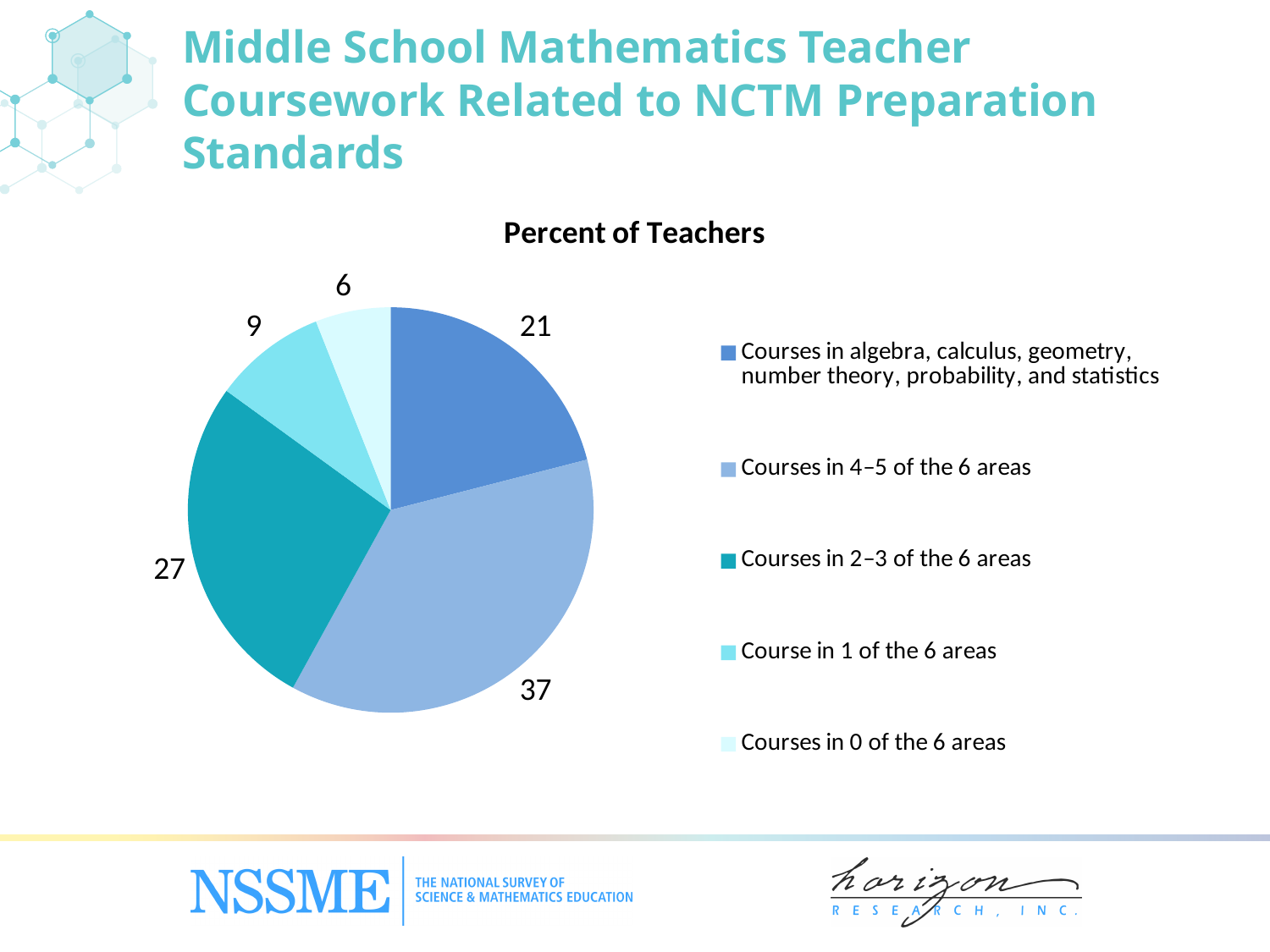
What percent of teachers had courses in 0 of the 6 areas? 6 Which category has the smallest slice of the pie? Courses in 0 of the 6 areas How many categories does the legend list? 5 Which is larger: the slice for courses in 2–3 of the 6 areas or the slice for courses in all six areas (algebra, calculus, geometry, number theory, probability, and statistics)? Courses in 2–3 of the 6 areas What type of chart is shown on the slide? pie chart What percent of teachers had a course in 1 of the 6 areas? 9 What is the chart's title? Percent of Teachers What percent of teachers had courses in algebra, calculus, geometry, number theory, probability, and statistics? 21 Which category has the largest slice of the pie? Courses in 4–5 of the 6 areas What is the combined percent of teachers with a course in 1 of the 6 areas and courses in 0 of the 6 areas? 15 What is the difference between the percent of teachers with courses in 4–5 of the 6 areas and those with courses in 2–3 of the 6 areas? 10 What percent of teachers had courses in 4–5 of the 6 areas? 37